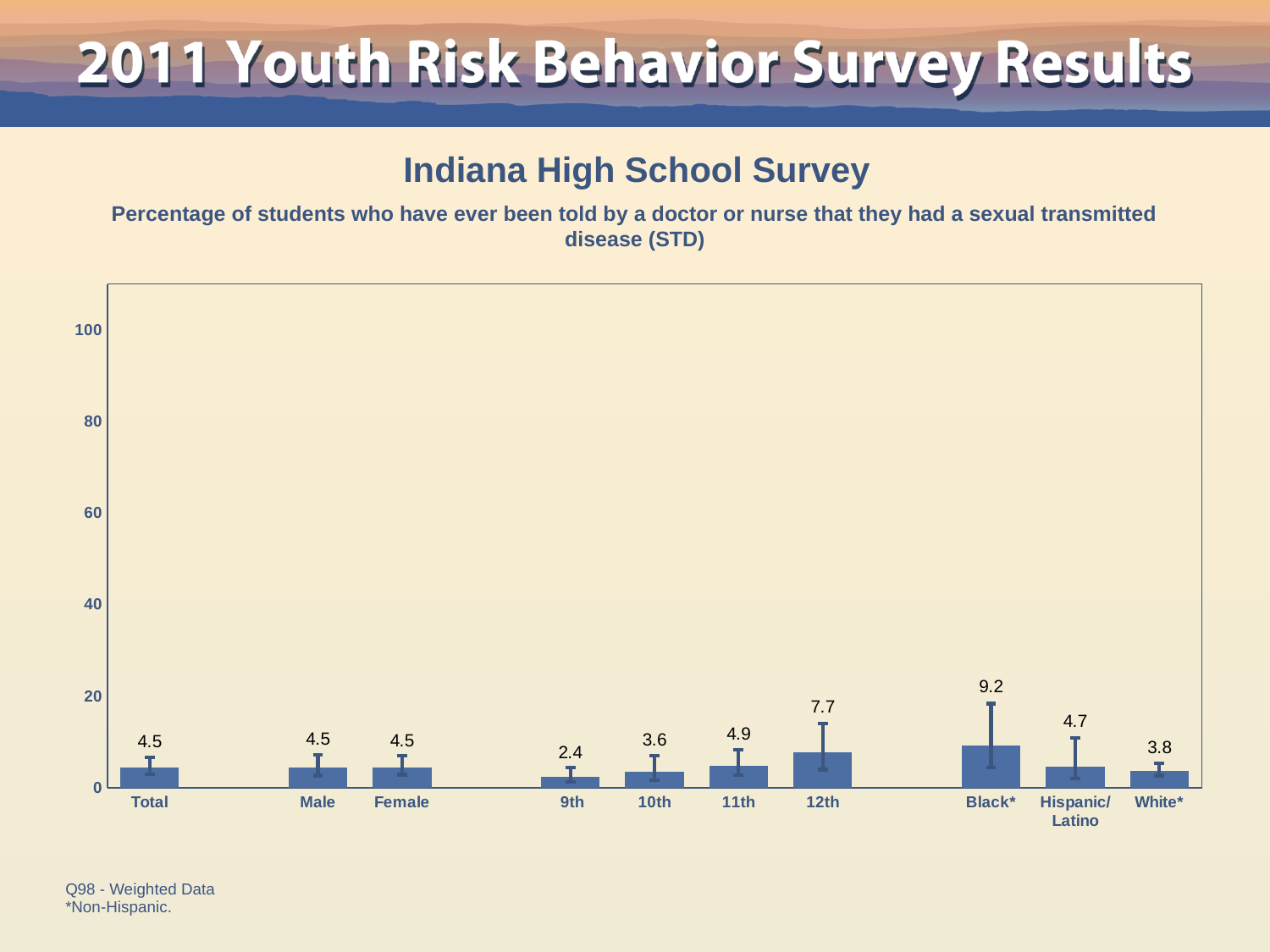
Do the values rise or fall from 9th to 12th grade? rise How many categories are shown on the x axis? 10 Which category has the highest value? Black* What is the value for Black*? 9.2 What is the value for 9th grade? 2.4 Which is larger, the value for 11th or the value for White*? 11th What is the value for Total? 4.5 Is the value for Black* greater or less than 20? less What kind of chart is this? bar chart What is the difference between the values for 12th and 9th? 5.3 What is the value for Hispanic/Latino? 4.7 Which category has the lowest value? 9th